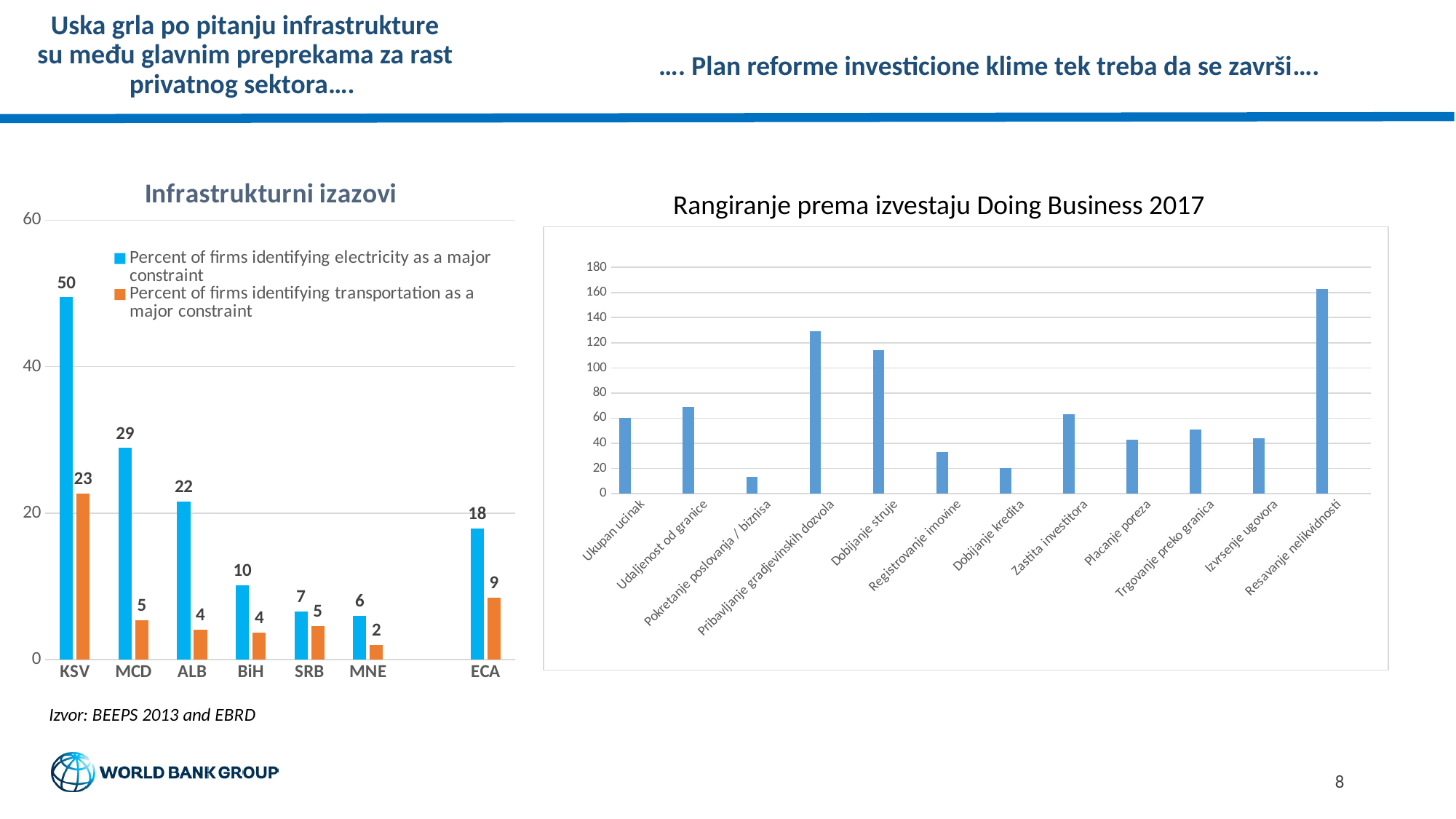
In the 'Rangiranje prema izvestaju Doing Business 2017' chart, is the value for Pribavljanje gradjevinskih dozvola greater or less than 120? greater In the 'Infrastrukturni izazovi' chart, which category has the highest value for electricity as a major constraint? KSV What kind of chart is 'Rangiranje prema izvestaju Doing Business 2017'? bar chart In the 'Infrastrukturni izazovi' chart, what is the difference between the electricity and transportation values for MCD? 24 In the 'Rangiranje prema izvestaju Doing Business 2017' chart, which category has the lowest value? Pokretanje poslovanja / biznisa How many series does the legend of the 'Infrastrukturni izazovi' chart list? 2 How many categories are shown on the x axis of the 'Infrastrukturni izazovi' chart? 7 In the 'Infrastrukturni izazovi' chart, what is the value for transportation as a major constraint for ECA? 9 In the 'Infrastrukturni izazovi' chart, which is larger: the electricity value for ALB or the electricity value for ECA? ALB In the 'Infrastrukturni izazovi' chart, what percent of firms in KSV identify electricity as a major constraint? 50 In the 'Rangiranje prema izvestaju Doing Business 2017' chart, which category has the highest value? Resavanje nelikvidnosti In the 'Infrastrukturni izazovi' chart, which category has the lowest value for transportation as a major constraint? MNE